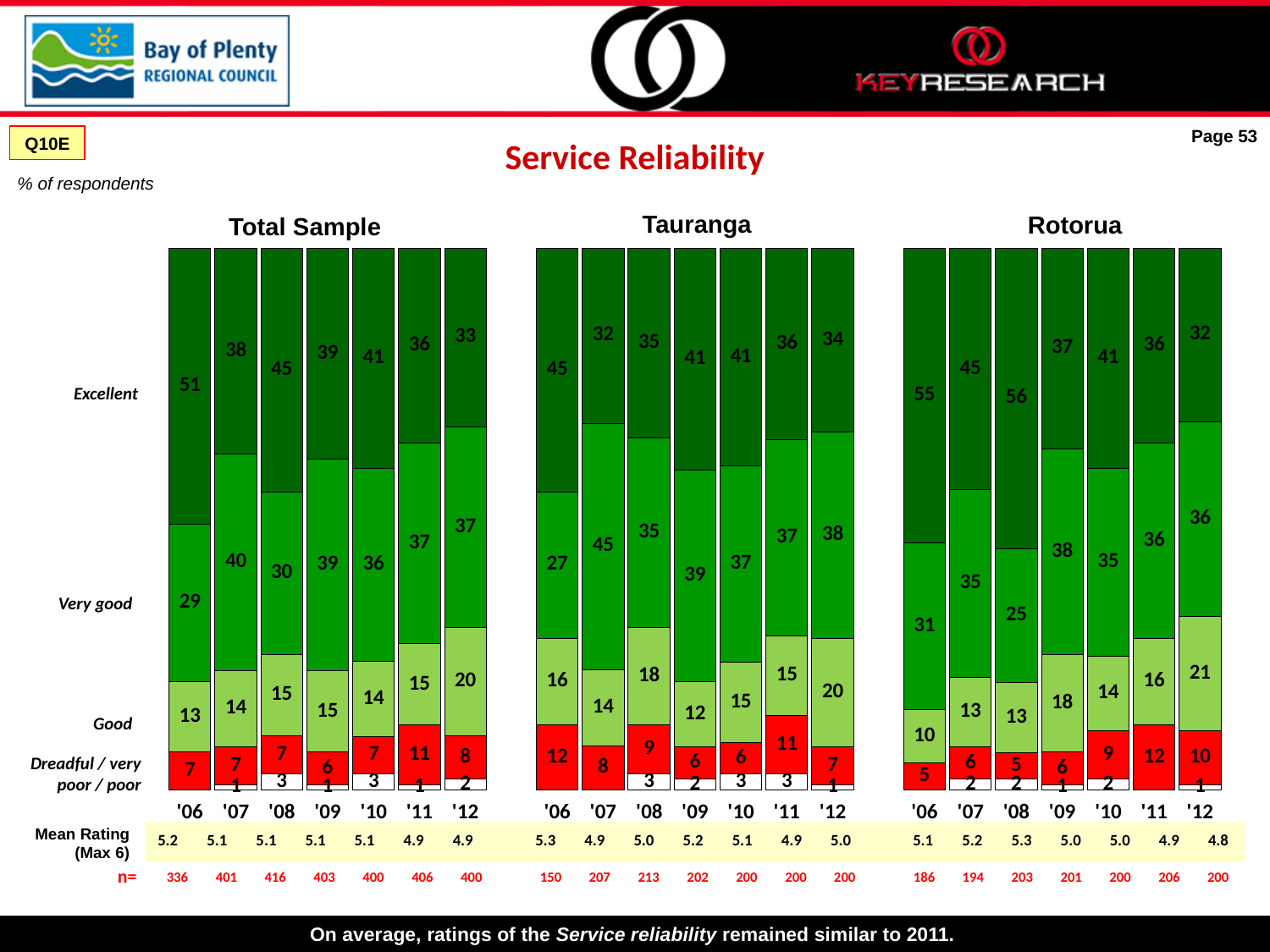
In the Tauranga chart, what is the Very good value for '07? 45 In the Rotorua chart, what is the Dreadful / very poor / poor value for '11? 12 What is the Mean Rating shown for Rotorua in '12? 4.8 In the Total Sample chart, what percentage of respondents rated service reliability as Excellent in '06? 51 How many charts are shown on the slide? 3 In the Tauranga chart, is the Excellent value larger in '06 or in '12? '06 In the Total Sample chart, which year has the highest Dreadful / very poor / poor value? '11 In the Rotorua chart, which year has the highest Good value? '12 In the Rotorua chart, does the Excellent value rise or fall from '10 to '12? Fall How many years are shown on the x axis of the Tauranga chart? 7 In the Total Sample chart, what is the difference between the Excellent value in '06 and the Excellent value in '12? 18 What type of chart is used for the Total Sample data? Stacked bar chart